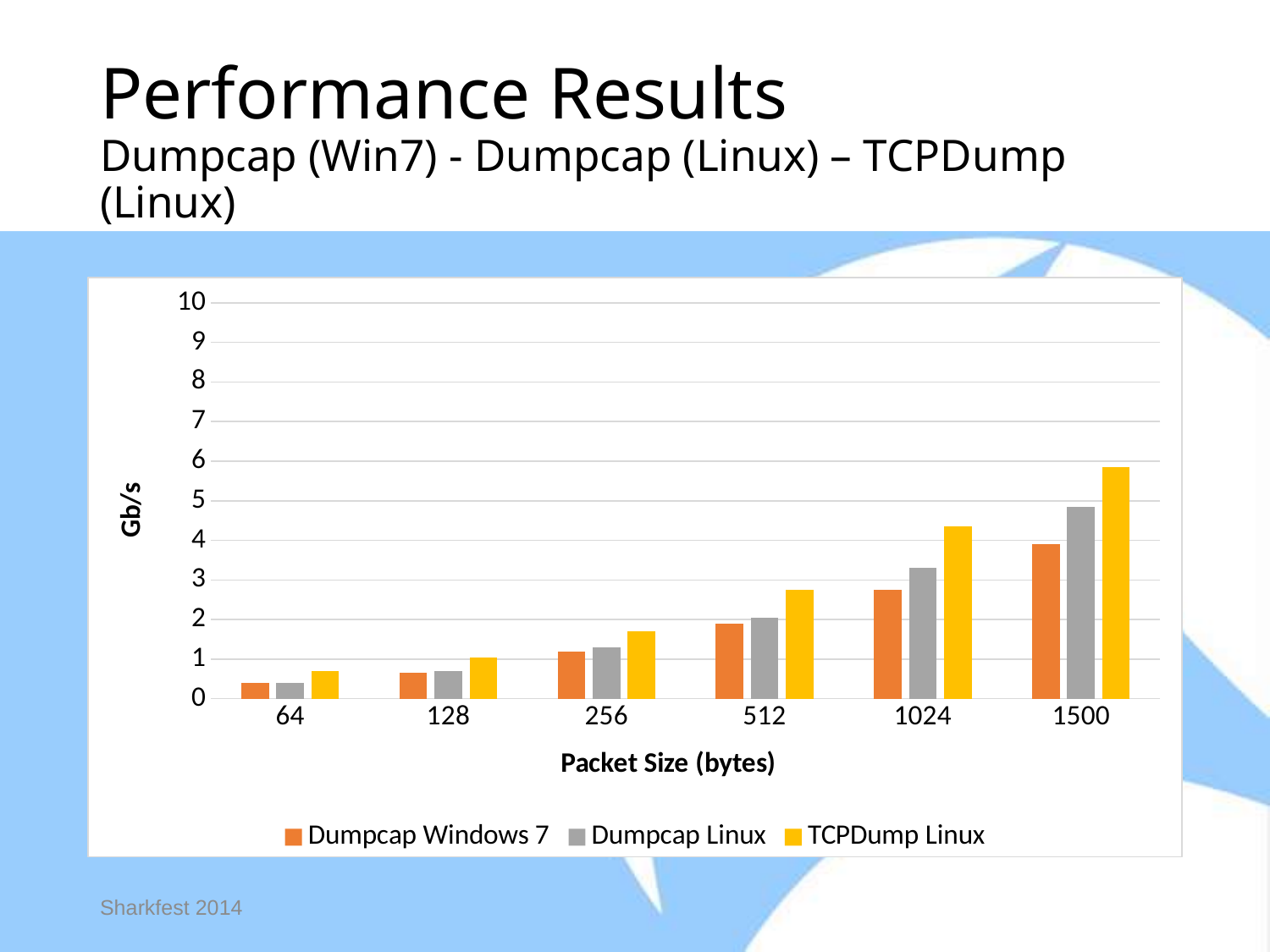
How many packet sizes are shown on the x axis? 6 What kind of chart is shown on the slide? bar chart How many series does the legend list? 3 Which packet size has the lowest Dumpcap Windows 7 value? 64 Is the TCPDump Linux value for packet size 1024 greater or less than 4? greater At packet size 1024, which is larger: Dumpcap Linux or Dumpcap Windows 7? Dumpcap Linux Which packet size has the highest TCPDump Linux value? 1500 Is the TCPDump Linux value for packet size 1500 greater or less than 5? greater What is the label of the y axis? Gb/s Is the Dumpcap Windows 7 value for packet size 64 greater or less than 1? less Do the TCPDump Linux values rise or fall as packet size increases along the x axis? rise